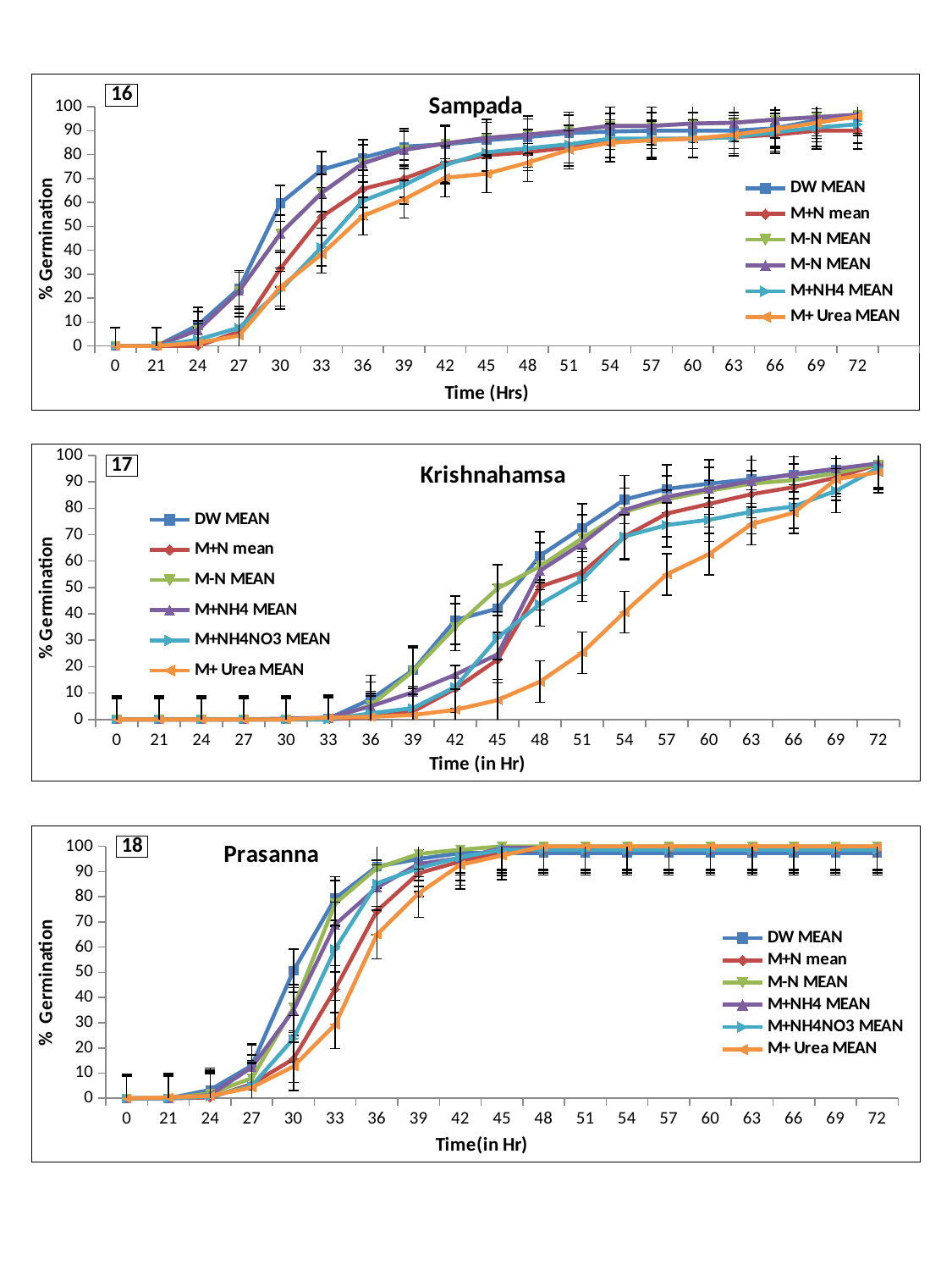
In the Krishnahamsa chart, is the value for M+ Urea MEAN at 54 hours greater or less than 50? less In the Krishnahamsa chart, which is larger at 54 hours: DW MEAN or M+ Urea MEAN? DW MEAN How many time points are shown on the x axis of the Prasanna chart? 19 In the Prasanna chart, do the values for DW MEAN rise or fall from 24 to 39 hours? rise In the Prasanna chart, is the value for DW MEAN at 33 hours greater or less than 70? greater What is the y-axis label of the Krishnahamsa chart? % Germination In the Sampada chart, is the value for DW MEAN at 30 hours greater or less than 50? greater What kind of chart is the Sampada chart? line chart In the Krishnahamsa chart, which series has the lowest value at 57 hours? M+ Urea MEAN How many series does the legend of the Krishnahamsa chart list? 6 In the Sampada chart, which is larger at 30 hours: DW MEAN or M+ Urea MEAN? DW MEAN What is the title of the bottom chart on the slide? Prasanna